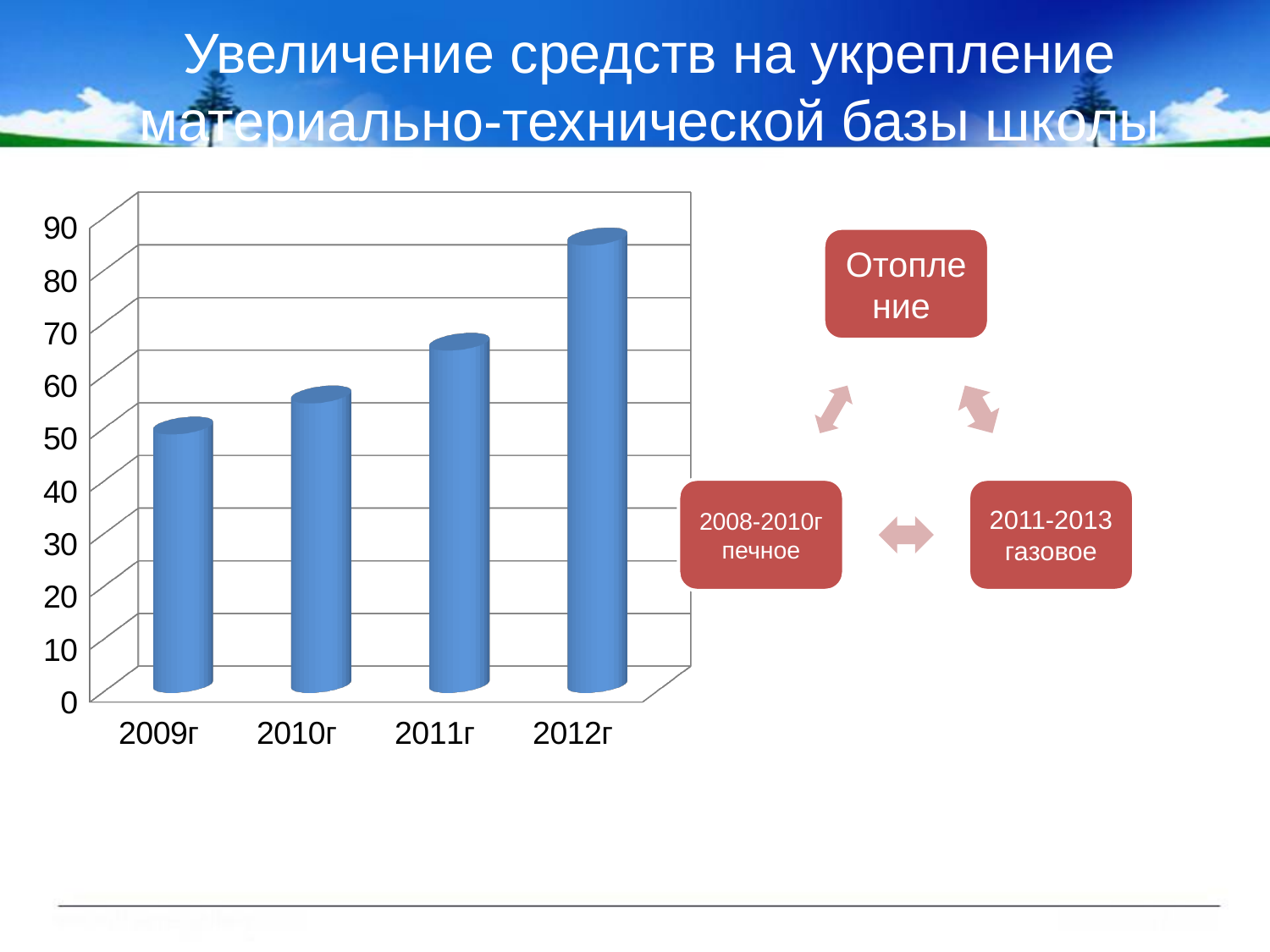
Is the value for 2010г greater or less than 50? greater Is the value for 2012г greater or less than 80? greater Which year has the lowest bar on the chart? 2009г What is the title of the slide containing the chart? Увеличение средств на укрепление материально-технической базы школы Which year has the highest bar on the chart? 2012г Is the value for 2009г greater or less than 60? less Which is larger, the value for 2011г or the value for 2010г? 2011г Which is larger, the value for 2009г or the value for 2012г? 2012г How many years (categories) are plotted on the chart? 4 What kind of chart is shown on the slide? bar chart Do the values rise or fall from 2009г to 2012г? rise